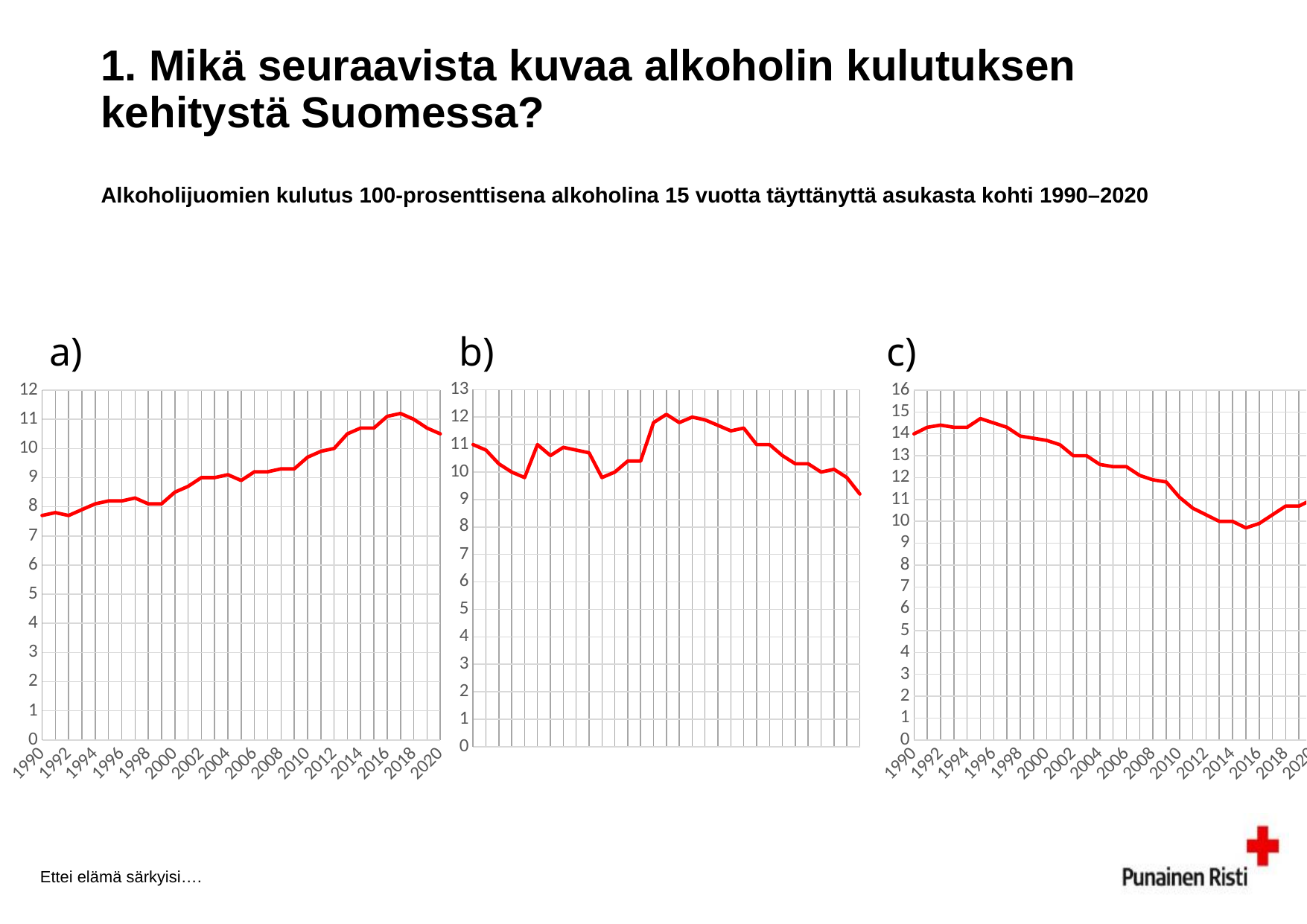
In chart a), do the values generally rise or fall from 1990 to 2020? rise In chart c), do the values generally rise or fall from 1990 to 2020? fall In chart b), is the highest point of the line greater or less than 11? greater What kind of chart is chart a)? line chart In chart c), is the value for 1990 greater or less than 13? greater In chart a), is the value for 2000 greater or less than 9? less What is the highest value shown on the y axis of chart b)? 13 How many charts are shown on the slide? 3 In chart c), which is larger, the value for 1990 or the value for 2020? 1990 In chart a), which is larger, the value for 1990 or the value for 2020? 2020